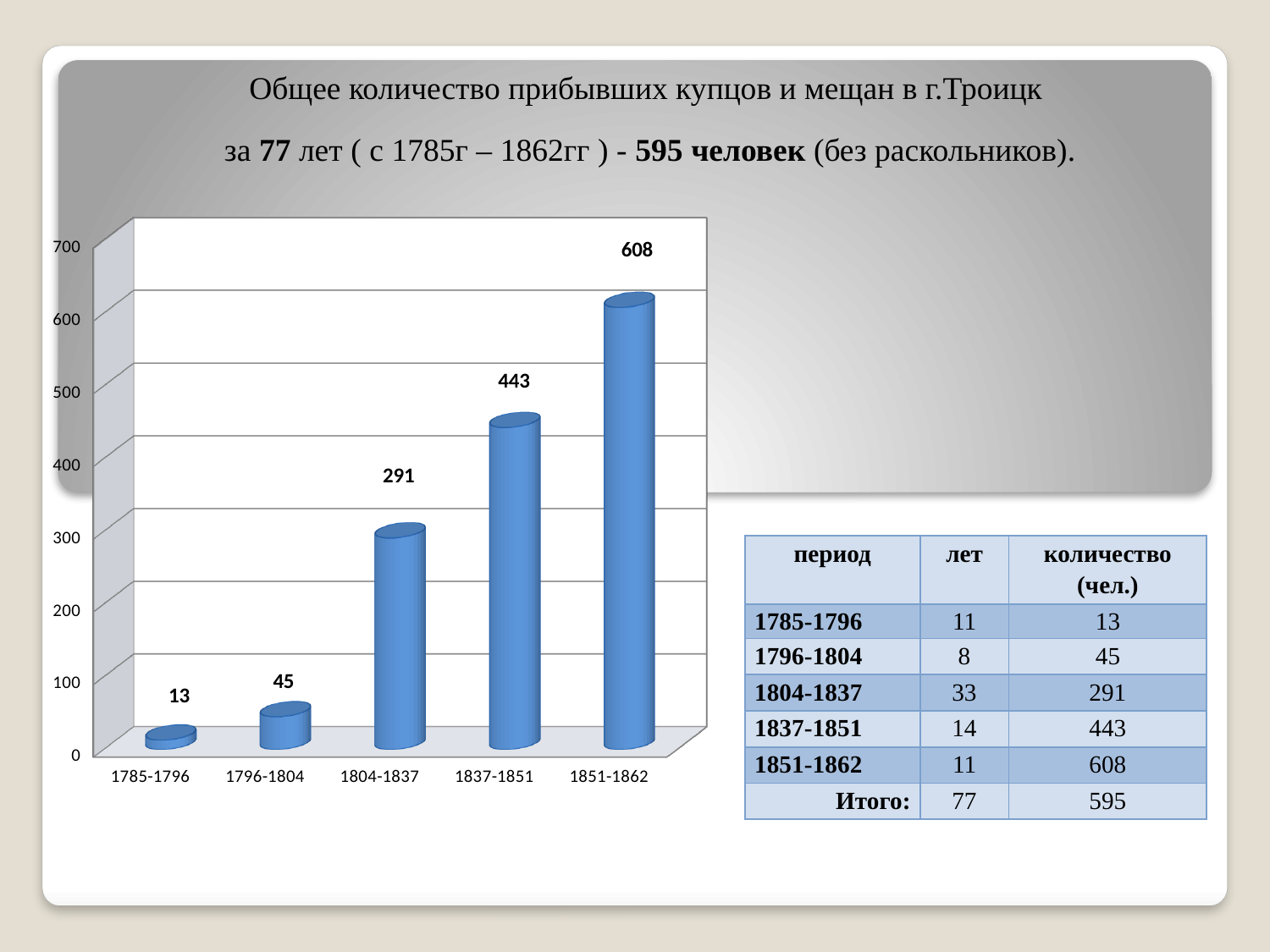
What is the difference between the values for 1796-1804 and 1785-1796? 32 Which period has the highest value? 1851-1862 How many periods are shown on the x axis? 5 What is the value for the period 1804-1837? 291 Which period has the lowest value? 1785-1796 Do the values rise or fall from left to right along the x axis? rise What is the value for the period 1785-1796? 13 What kind of chart is shown? bar chart Is the value for 1837-1851 greater or less than 400? greater What is the value for the period 1851-1862? 608 What is the difference between the values for 1851-1862 and 1837-1851? 165 Which is larger, the value for 1837-1851 or the value for 1804-1837? 1837-1851